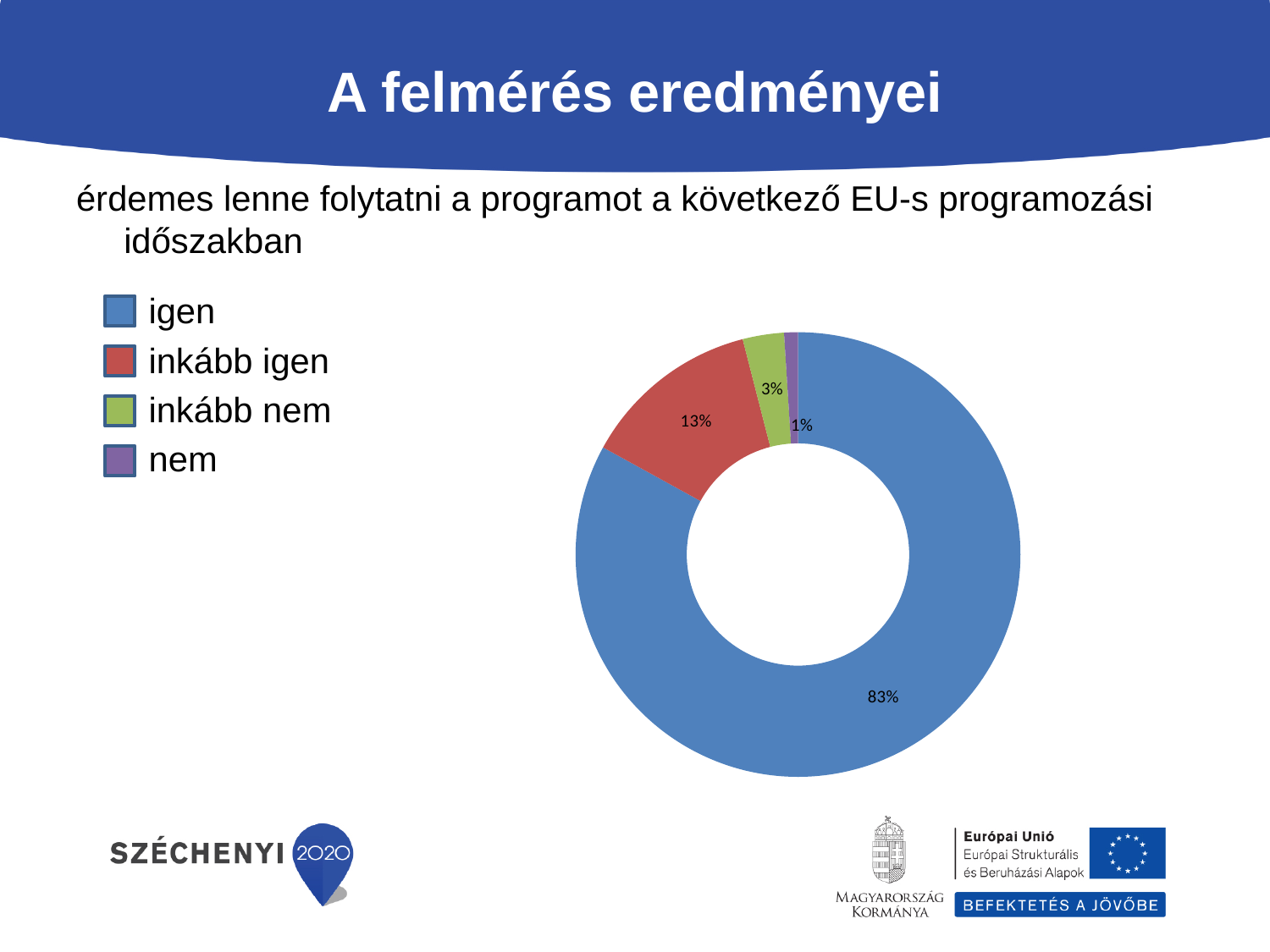
What percentage of respondents answered "inkább nem"? 3% What percentage of respondents answered "igen"? 83% What is the difference in percentage points between "igen" and "inkább igen"? 70 What type of chart is shown on the slide? Doughnut (pie) chart What is the combined share of "igen" and "inkább igen"? 96% Which answer category has the largest share of the chart? igen Which is larger, the share for "inkább nem" or the share for "nem"? inkább nem What percentage of respondents answered "nem"? 1% What colour represents the "inkább igen" category in the legend? Red What percentage of respondents answered "inkább igen"? 13% Which answer category has the smallest share of the chart? nem How many answer categories are shown in the chart? 4